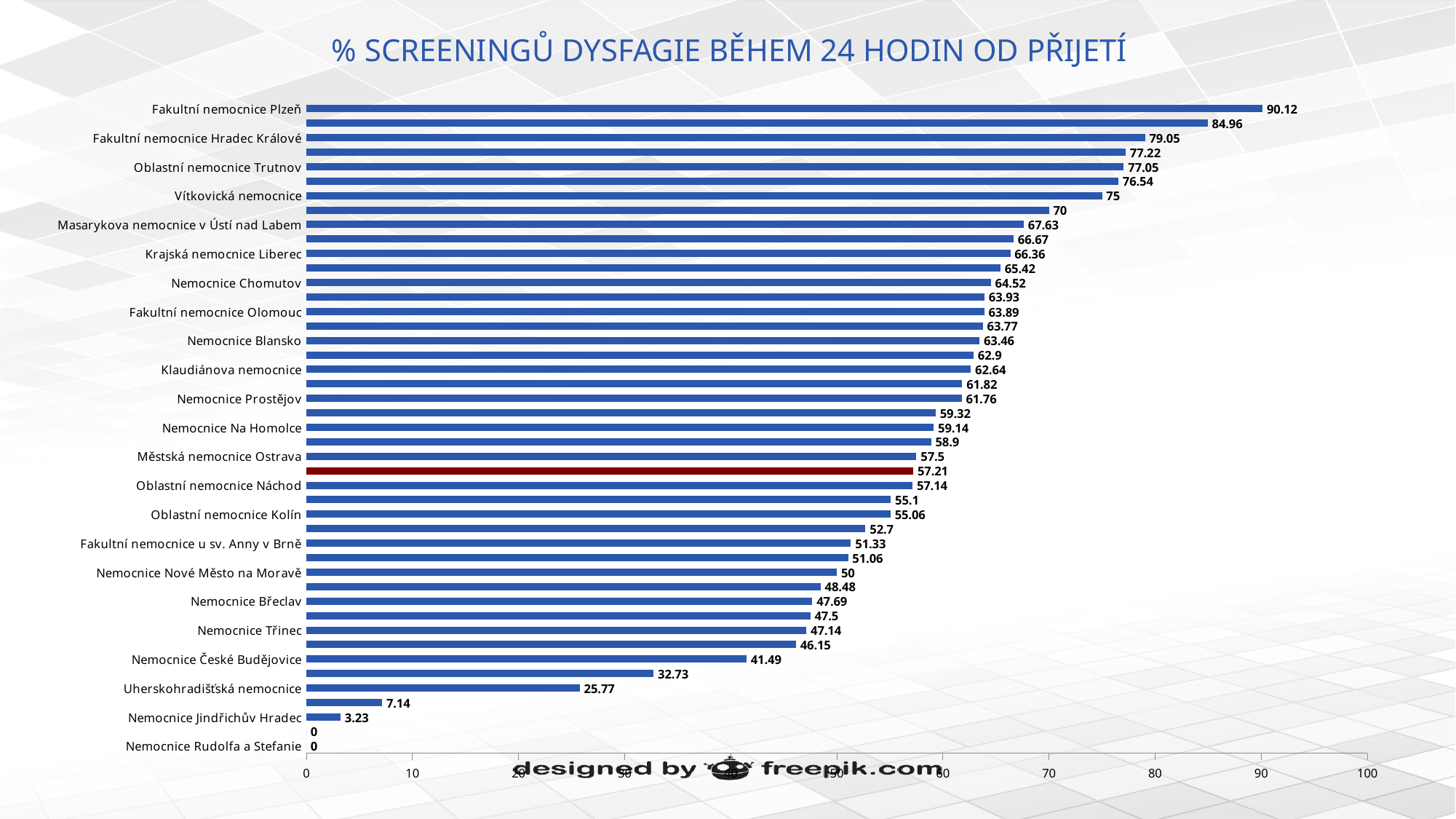
Which has a larger value, Nemocnice Břeclav or Nemocnice České Budějovice? Nemocnice Břeclav What is the value for Nemocnice Chomutov? 64.52 What kind of chart is shown on the slide? Bar chart What is the difference between the values for Fakultní nemocnice Plzeň and Fakultní nemocnice Hradec Králové? 11.07 What is the value for Uherskohradišťská nemocnice? 25.77 What is the value for Fakultní nemocnice Plzeň? 90.12 Which hospital has the highest value on the chart? Fakultní nemocnice Plzeň What is the value for Vítkovická nemocnice? 75 What is the value of the bar highlighted in dark red? 57.21 Is the value for Oblastní nemocnice Trutnov greater or less than 70? greater What is the title of the chart? % SCREENINGŮ DYSFAGIE BĚHEM 24 HODIN OD PŘIJETÍ What is the lowest value shown on the chart? 0